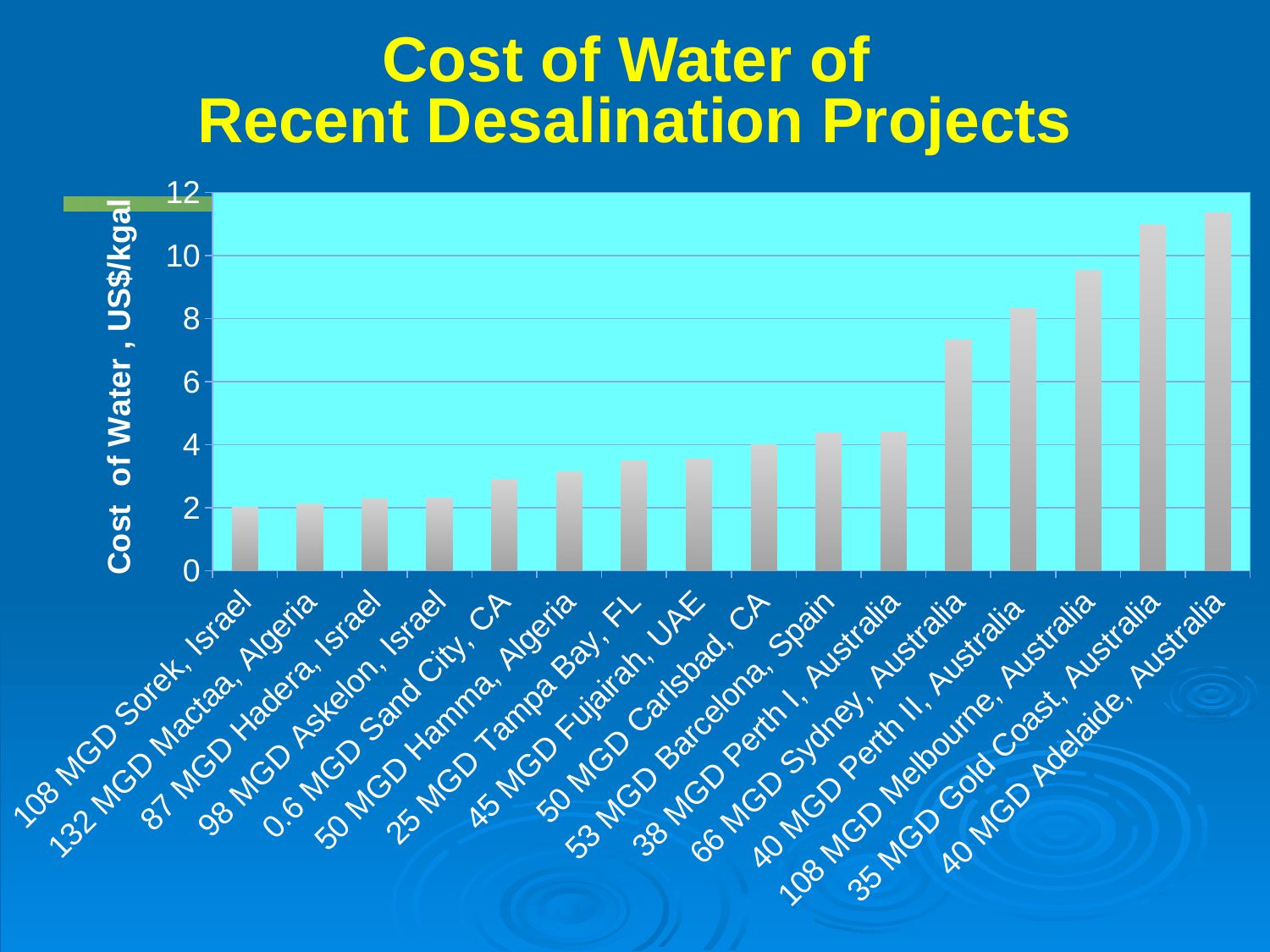
Is the cost of water for 50 MGD Carlsbad, CA greater or less than 6? less How many desalination projects are plotted on the chart? 16 Do the bar values rise or fall from left to right along the x axis? Rise Which has a higher cost of water: 108 MGD Sorek, Israel or 66 MGD Sydney, Australia? 66 MGD Sydney, Australia Which has a higher cost of water: 108 MGD Melbourne, Australia or 40 MGD Perth II, Australia? 108 MGD Melbourne, Australia What is the label of the vertical axis? Cost of Water , US$/kgal What is the title of the slide's chart? Cost of Water of Recent Desalination Projects Is the cost of water for 25 MGD Tampa Bay, FL greater or less than 4? less Is the cost of water for 66 MGD Sydney, Australia greater or less than 6? greater Which project has the highest cost of water? 40 MGD Adelaide, Australia What kind of chart is shown on the slide? Bar chart